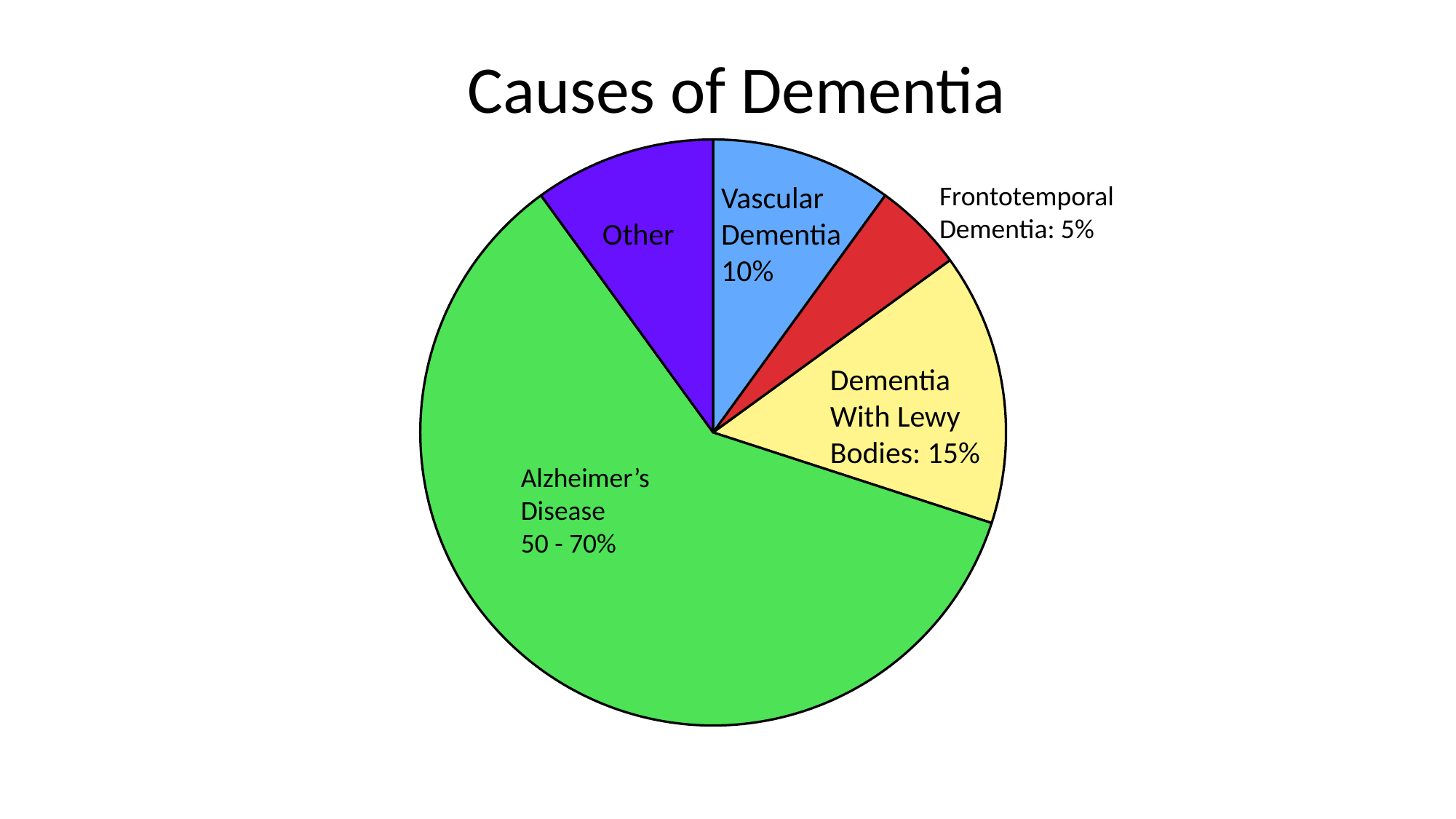
What percentage is shown for Vascular Dementia? 10% What is the title of the chart? Causes of Dementia What is the difference in percentage points between Dementia With Lewy Bodies and Frontotemporal Dementia? 10% What kind of chart is shown on the slide? Pie chart Which slice of the pie is labelled without a percentage value? Other How many slices does the pie chart have? 5 Which cause of dementia has the largest slice of the pie? Alzheimer's Disease Which is larger, the share for Dementia With Lewy Bodies or the share for Vascular Dementia? Dementia With Lewy Bodies What percentage is shown for Frontotemporal Dementia? 5% Which cause of dementia has the smallest slice of the pie? Frontotemporal Dementia What range is shown for Alzheimer's Disease? 50 - 70% What percentage is shown for Dementia With Lewy Bodies? 15%